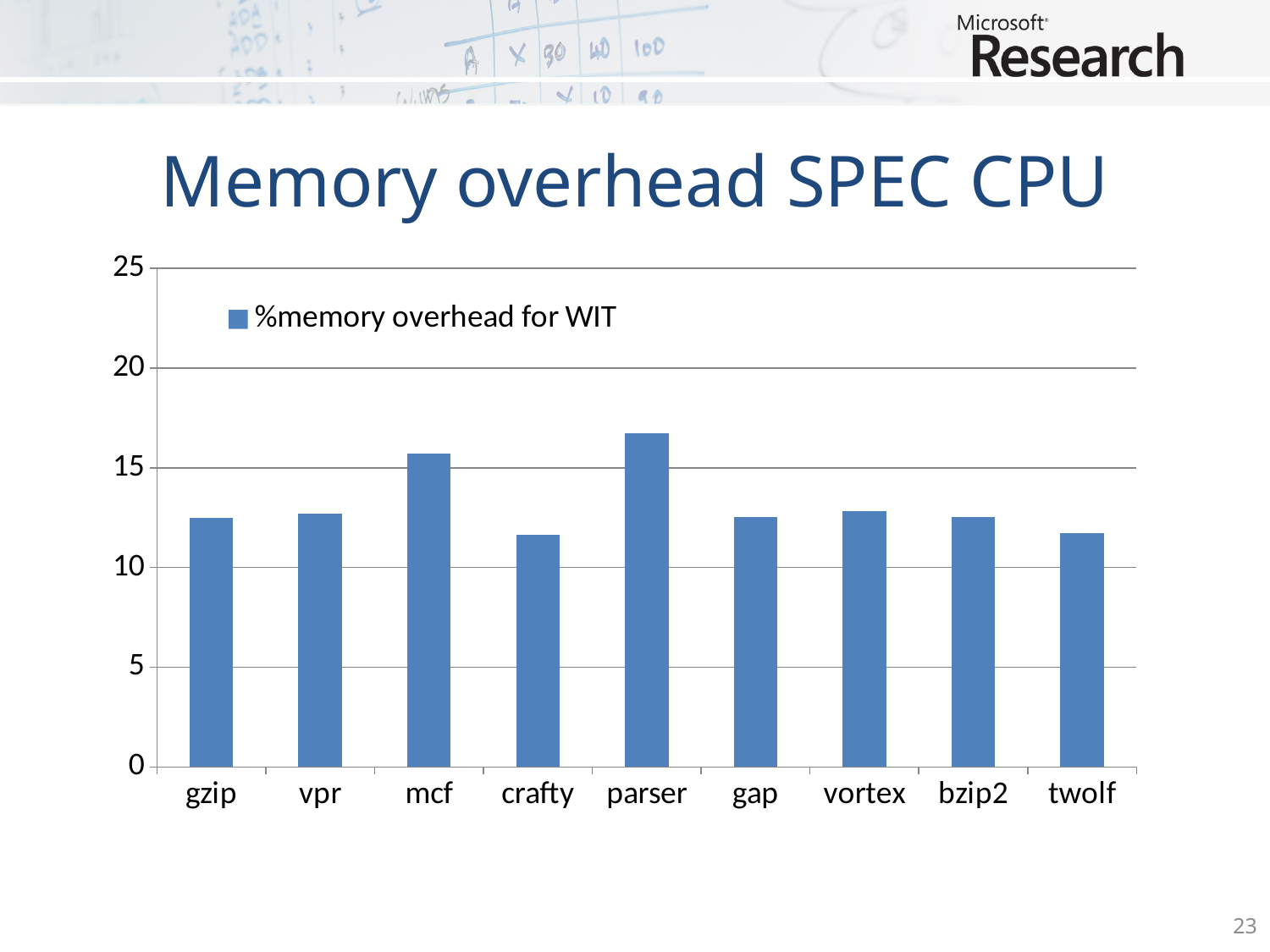
Is the value for parser greater or less than 20? less Which has the larger memory overhead, parser or gzip? parser How many benchmark categories are plotted on the x axis? 9 How many series does the legend list? 1 Which has the larger memory overhead, mcf or crafty? mcf Which benchmark has the highest memory overhead? parser What is the title of the chart? Memory overhead SPEC CPU Is the value for crafty greater or less than 15? less Is the value for gzip greater or less than 10? greater What is the legend entry for the plotted series? %memory overhead for WIT What kind of chart is shown on the slide? bar chart